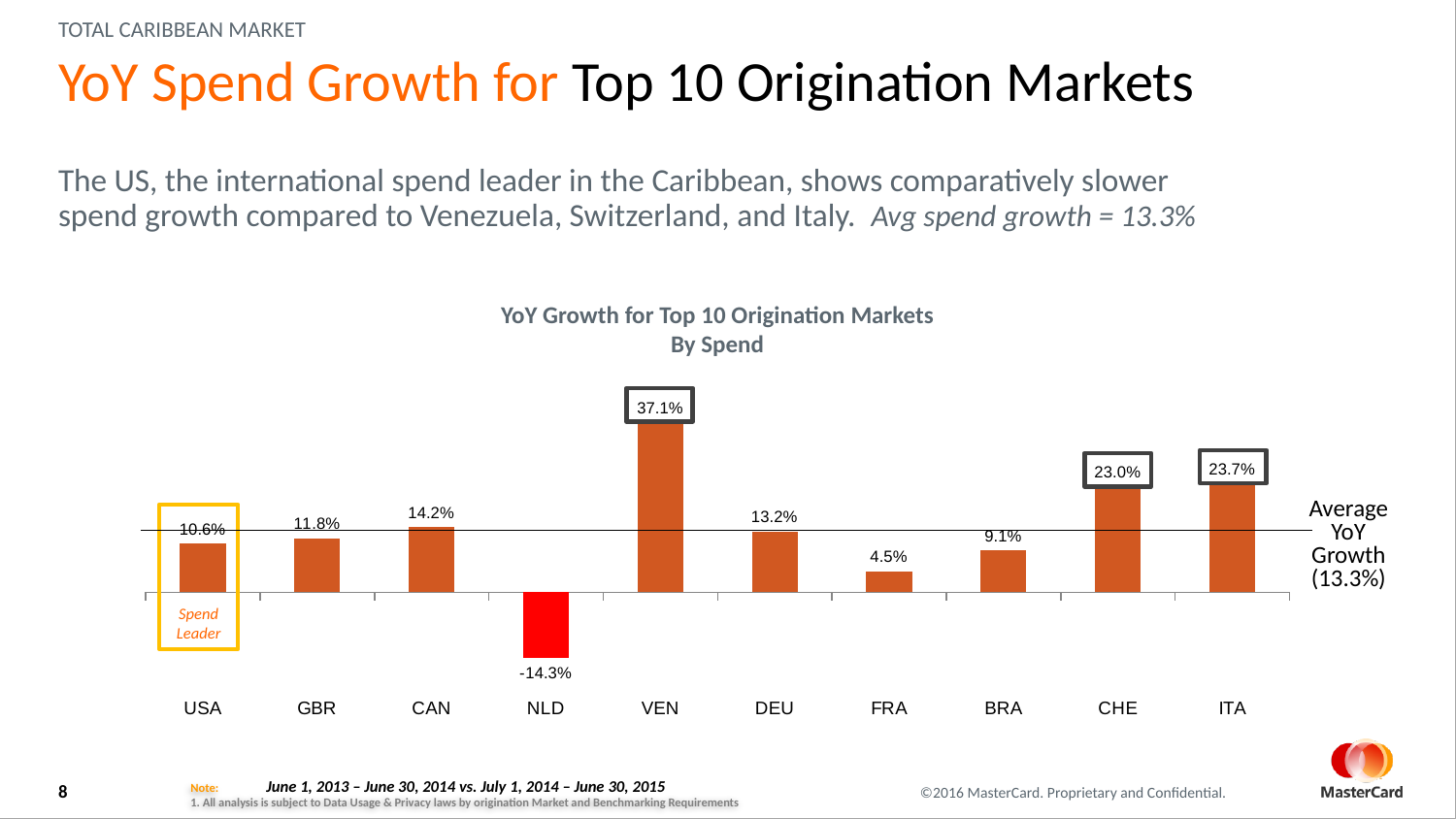
What is the difference between the YoY spend growth of VEN and USA? 26.5% Which has a higher YoY spend growth, FRA or BRA? BRA Which has a higher YoY spend growth, CAN or GBR? CAN What kind of chart is used to show YoY growth for the top 10 origination markets? Bar chart What is the difference between the YoY spend growth of ITA and CHE? 0.7% Which origination market has the highest YoY spend growth? VEN What is the YoY spend growth value for NLD? -14.3% Which origination market has the lowest YoY spend growth? NLD What is the YoY spend growth value for VEN? 37.1% What is the Average YoY Growth value marked by the horizontal line on the chart? 13.3% How many origination markets are shown in the chart? 10 What is the YoY spend growth value for USA? 10.6%